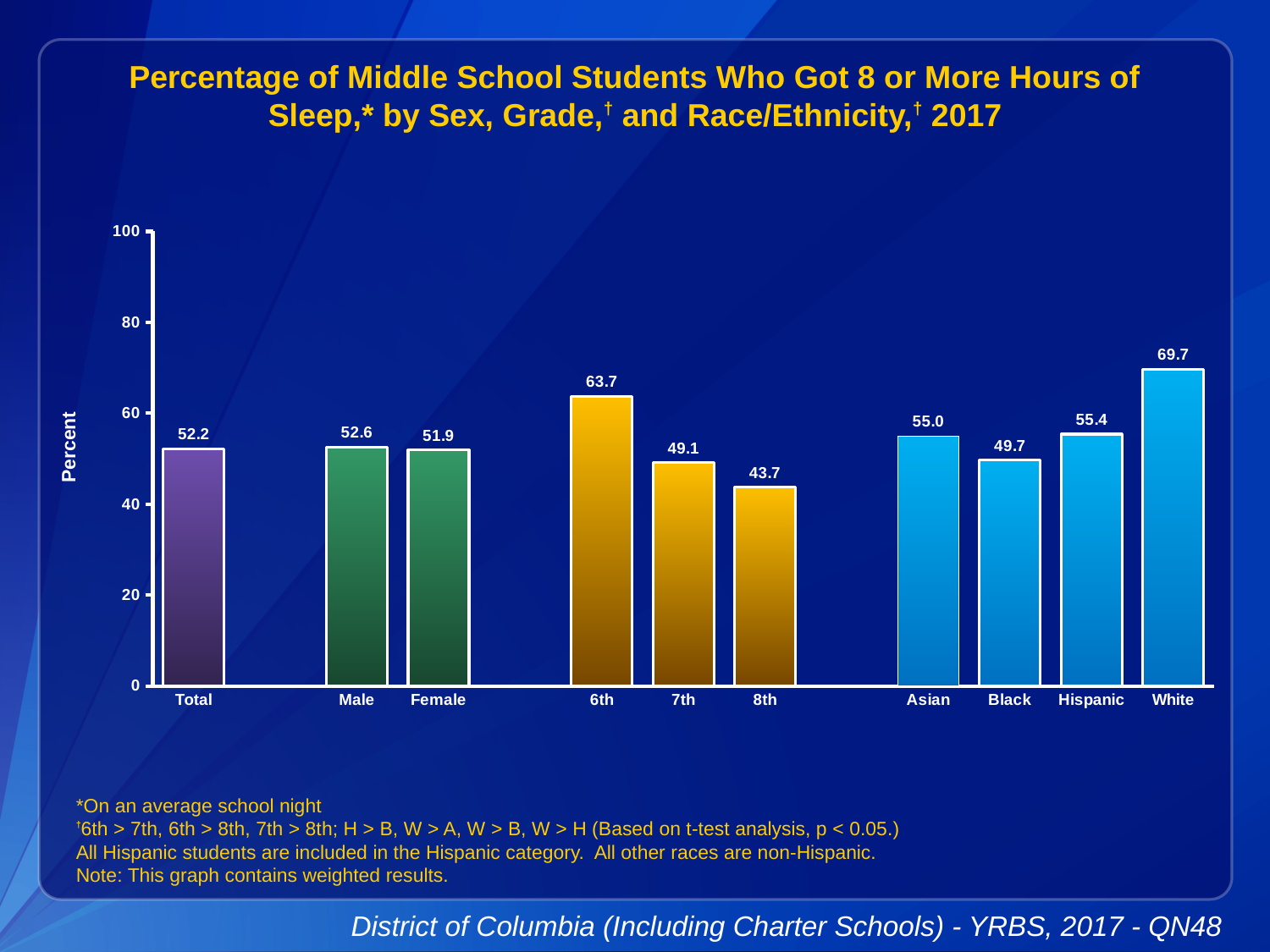
Which category has the highest value? White What is the value for Total? 52.2 Is the value for White greater or less than 60? greater What is the difference between the values for 6th and 8th grade? 20.0 How many categories are shown on the x axis? 10 What is the difference between the values for Male and Female? 0.7 What is the value for 6th grade students? 63.7 What is the value for Hispanic students? 55.4 Which category has the lowest value? 8th Do the values rise or fall from 6th to 8th grade? fall Which is larger, the value for Asian or the value for Black? Asian What kind of chart is this? bar chart